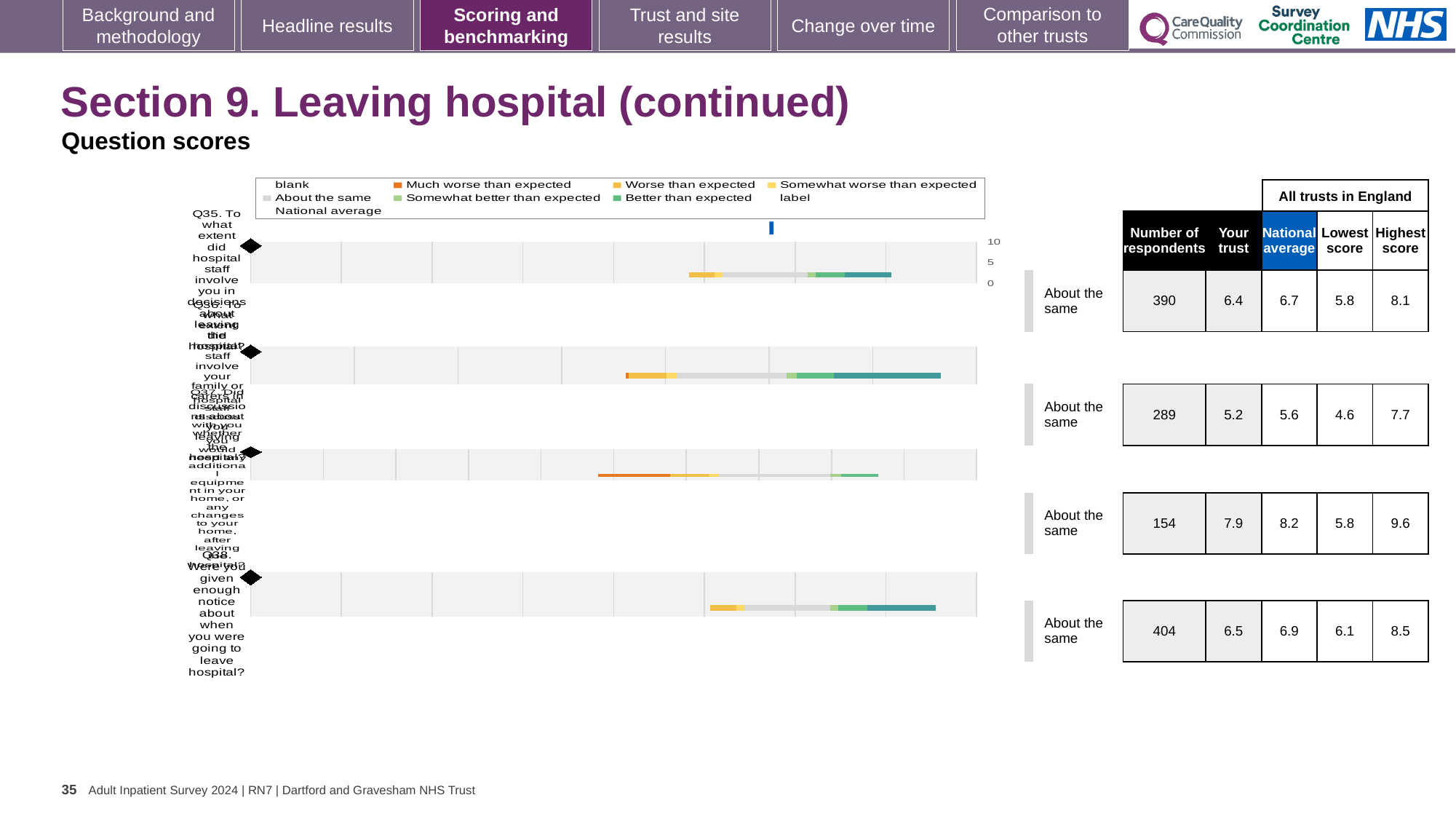
How many questions (rows) are plotted in the chart? 4 What kind of chart is used to show the question scores on this slide? bar chart Which question has the highest 'Your trust' score? Q37 Which question has the lowest national average score? Q36 How many of the plotted questions are rated 'About the same'? 4 For Q38, how much higher is the national average than the 'Your trust' score? 0.4 What benchmark category is shown for Q36? About the same What is the 'Your trust' score for Q35 (the first row)? 6.4 In the legend, what does the dark blue marker represent? National average What is the number of respondents for Q38 (the last row)? 404 For Q37, what is the difference between the highest score and the lowest score across all trusts in England? 3.8 For Q35, which is larger: the 'Your trust' score or the national average? National average